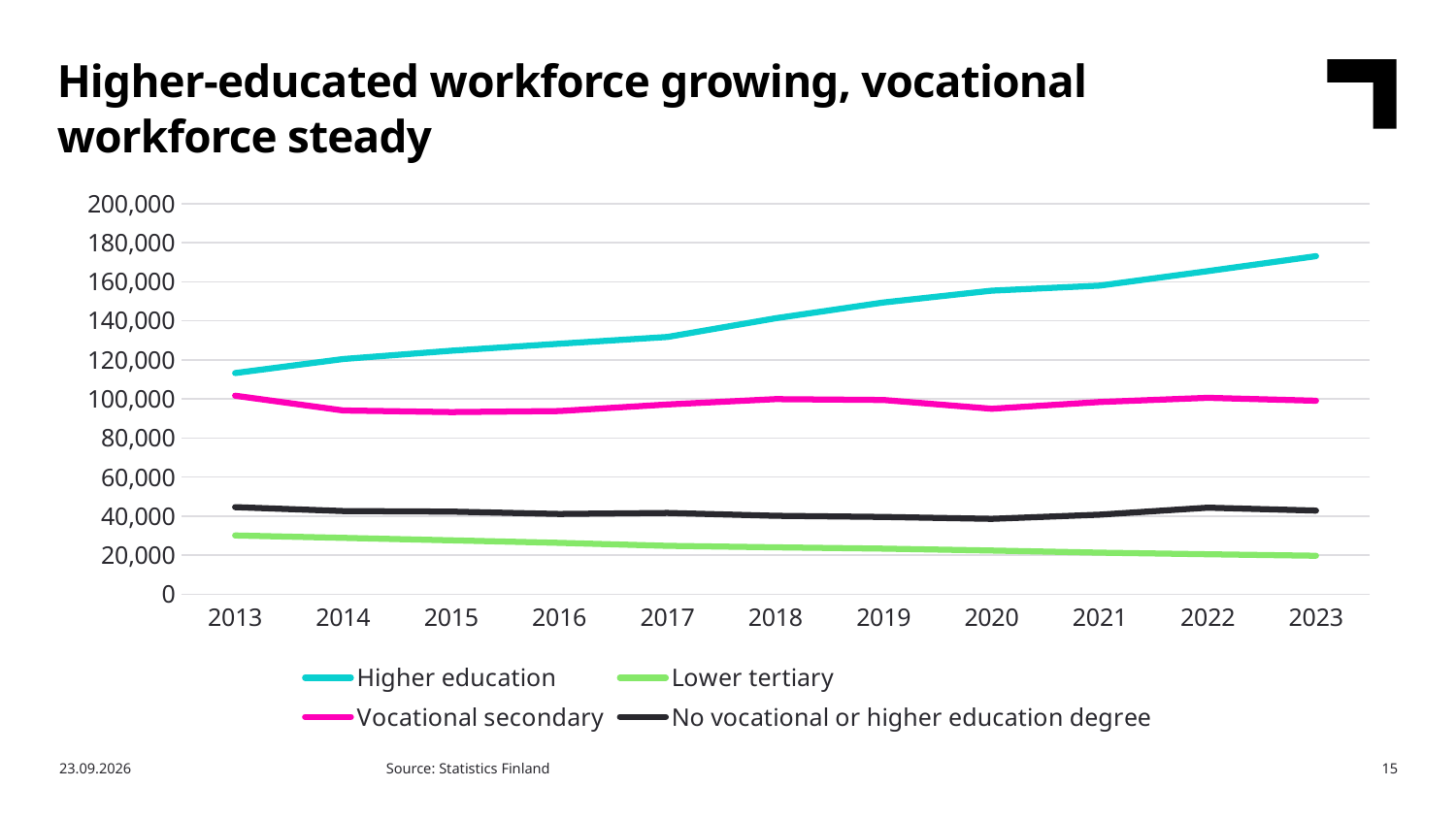
How many years are shown on the x axis? 11 Does the Higher education line rise or fall from 2013 to 2023? Rises In 2019, which is larger: Vocational secondary or No vocational or higher education degree? Vocational secondary What is the title of the slide? Higher-educated workforce growing, vocational workforce steady Which series has the lowest value in 2023? Lower tertiary How many series does the legend list? 4 Is the value for Higher education in 2023 greater or less than 160,000? greater Which series has the highest value in 2023? Higher education What kind of chart is shown on the slide? Line chart Is the value for Vocational secondary in 2016 greater or less than 100,000? less Does the Lower tertiary line rise or fall from 2013 to 2023? Falls Is the value for Lower tertiary in 2013 greater or less than 20,000? greater